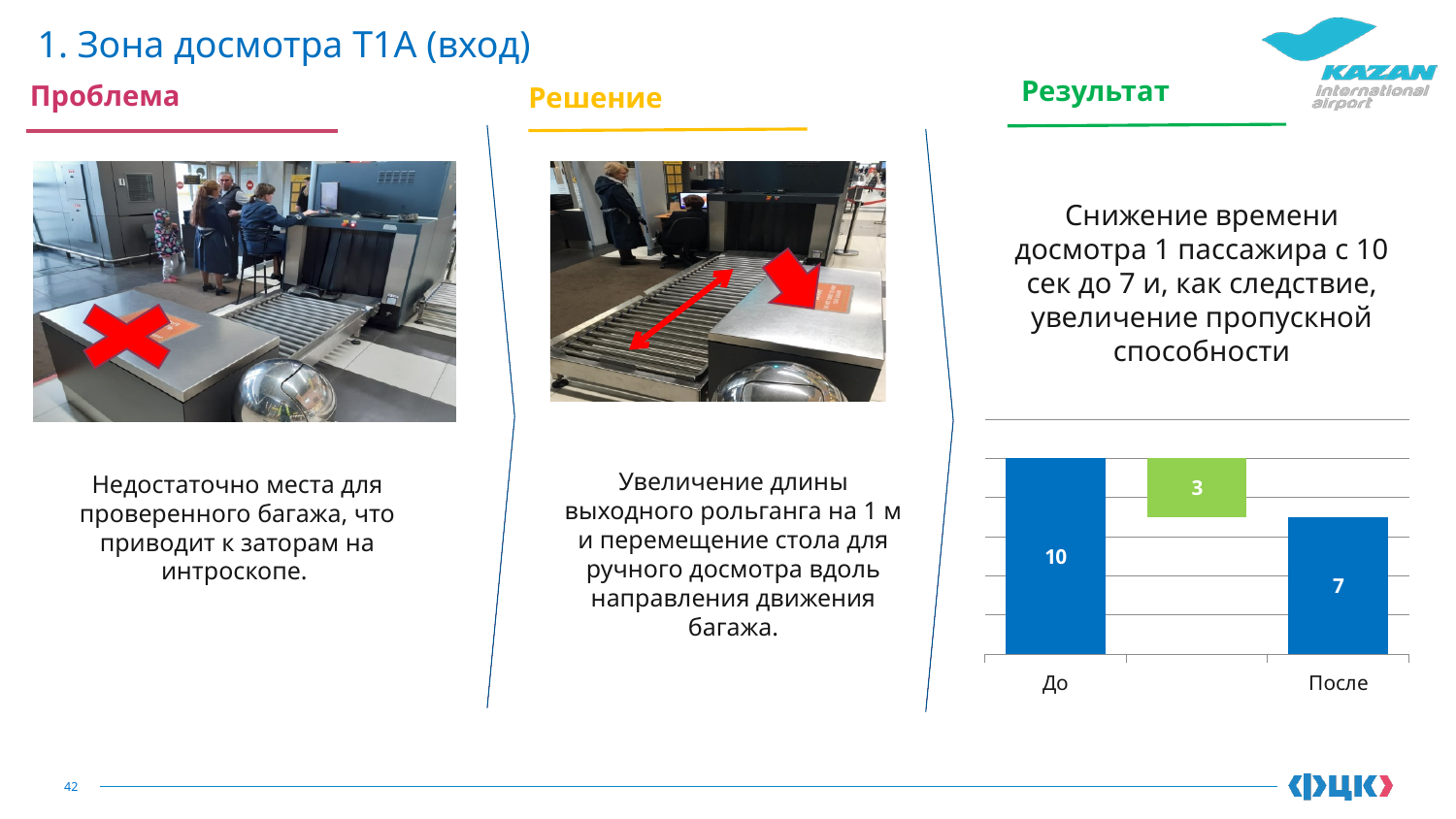
Which category has the higher value, "До" or "После"? До What kind of chart is shown on the slide? Bar chart What is the value for "До" in the chart? 10 What is the value for "После" in the chart? 7 How many categories are labelled on the x axis of the chart? 2 What value is printed on the green bar between "До" and "После"? 3 Which of the two labelled categories on the x axis has the lowest value? После What colour are the bars for "До" and "После"? Blue What is the difference between the values for "До" and "После"? 3 Do the values fall or rise from "До" to "После"? Fall What colour is the bar labelled 3? Green